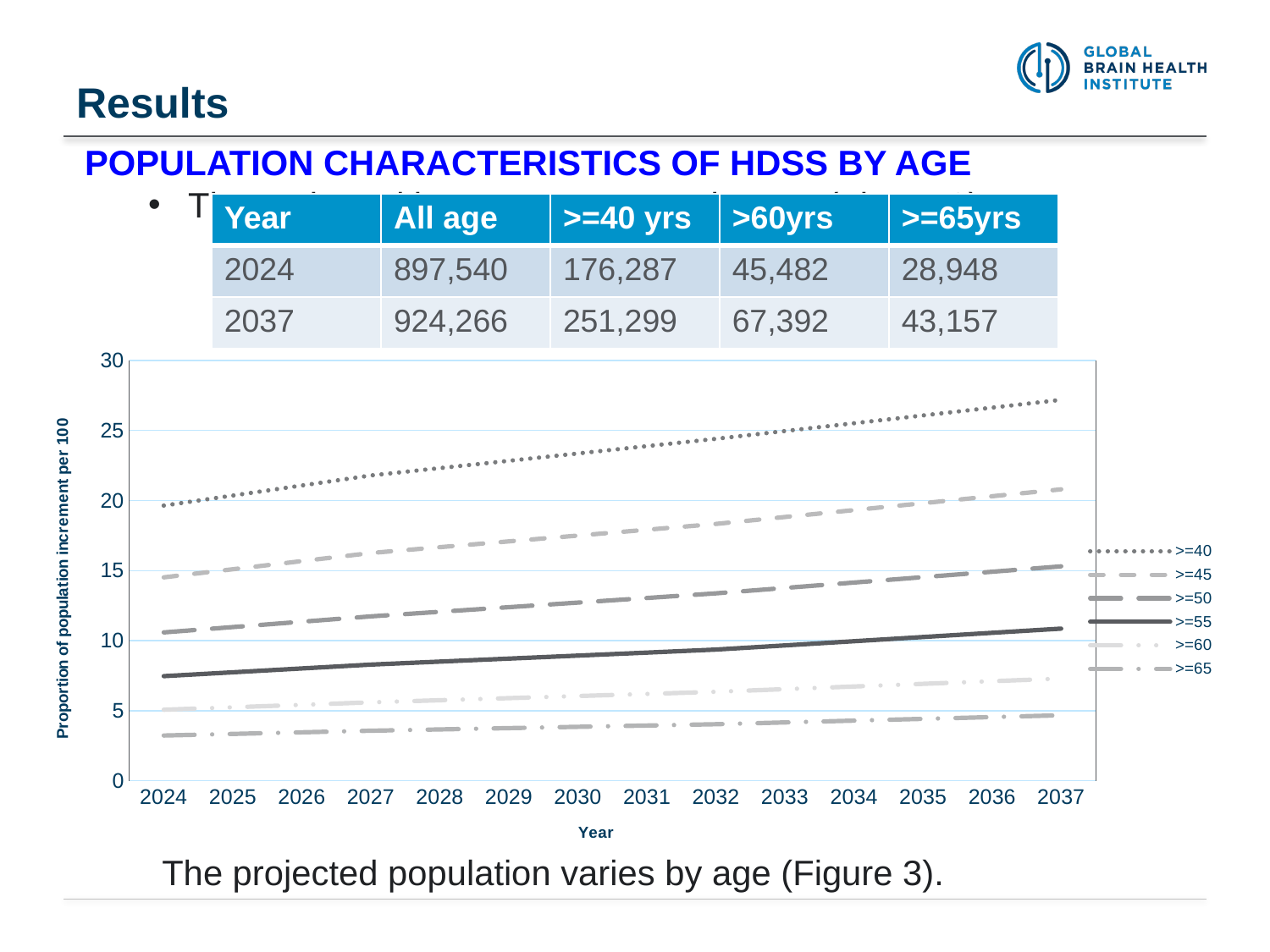
Is the value for the >=60 series in 2037 greater or less than 5? greater Is the value for the >=55 series in 2024 greater or less than 10? less What kind of chart is shown on the slide? line chart Which series has the highest values across the chart? >=40 In 2037, which series has the larger value, >=45 or >=50? >=45 What is the title of the chart's vertical axis? Proportion of population increment per 100 How many years are plotted along the x axis of the chart? 14 How many series does the chart legend list? 6 Does the value for the >=40 series rise or fall from 2024 to 2037? rise Which series has the lowest values across the chart? >=65 Is the value for the >=40 series in 2037 greater or less than 25? greater